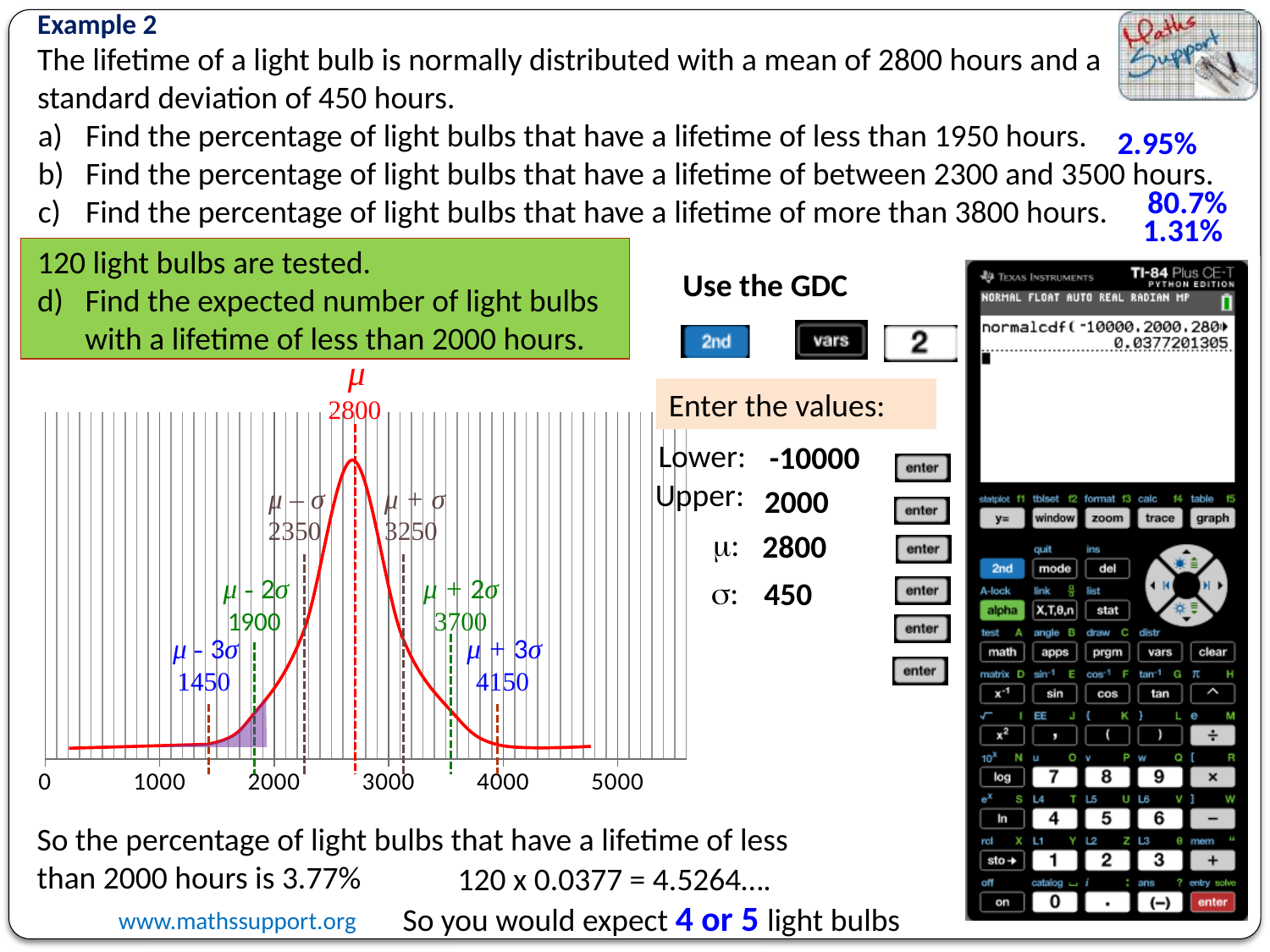
What value is labelled at the dashed line marked μ − 2σ? 1900 What value is labelled at the dashed line marked μ + 3σ? 4150 What is the difference between the values labelled μ + σ and μ − σ on the chart? 900 Is the shaded region under the curve located to the left or right of the peak? Left How many numbered tick labels are shown on the x axis of the chart? 6 What value is labelled at the dashed line marked μ + σ? 3250 What is the difference between the values labelled μ + 3σ and μ − 3σ on the chart? 2700 What value is labelled at the dashed line marked μ − σ? 2350 What colour is the curve drawn on the chart? Red What value is labelled at the peak of the curve, marked μ? 2800